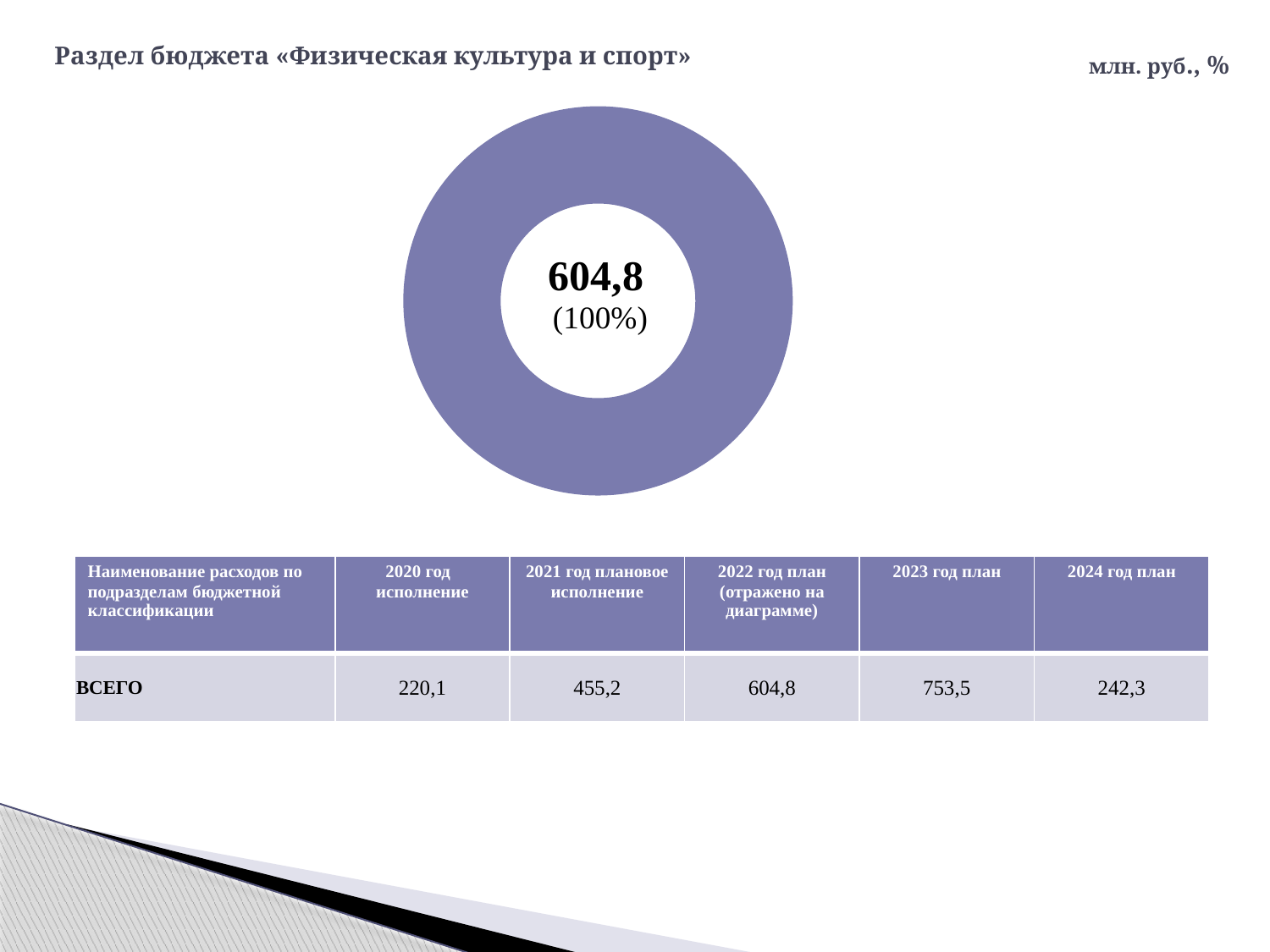
What kind of chart is shown on the slide? Pie (donut) chart Which year's plan does the donut chart reflect, according to the table header? 2022 год план What percentage share is shown for the single segment of the donut chart? 100% What is the title of the slide containing the donut chart? Раздел бюджета «Физическая культура и спорт» In what units are the values on the slide expressed, according to the label in the top right corner? млн. руб., % Is the value shown in the donut chart greater or less than 600? greater What value is printed in the centre of the donut chart? 604,8 How many segments does the donut chart contain? 1